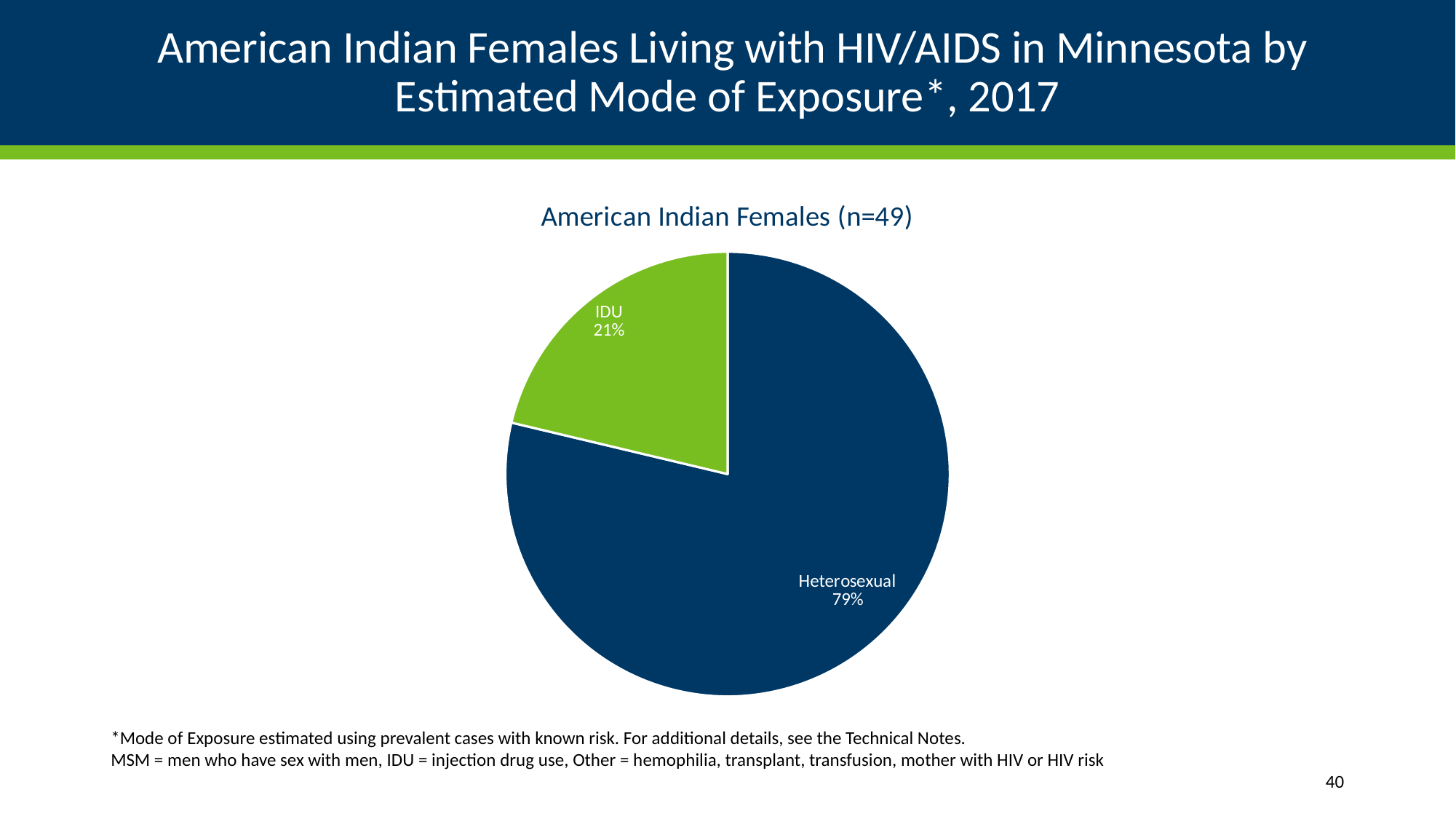
What is the combined share of the Heterosexual and IDU slices? 100% What type of chart is shown on the slide? pie chart Which mode of exposure has the largest share of the pie? Heterosexual What percentage of American Indian females living with HIV/AIDS is attributed to IDU? 21% What is the difference in percentage points between the Heterosexual and IDU shares? 58 Which is larger, the Heterosexual share or the IDU share? Heterosexual What is the title of the pie chart? American Indian Females (n=49) What is the sample size (n) shown in the chart title? 49 What percentage of American Indian females living with HIV/AIDS is attributed to Heterosexual exposure? 79% Which mode of exposure has the smallest share of the pie? IDU How many slices does the pie chart have? 2